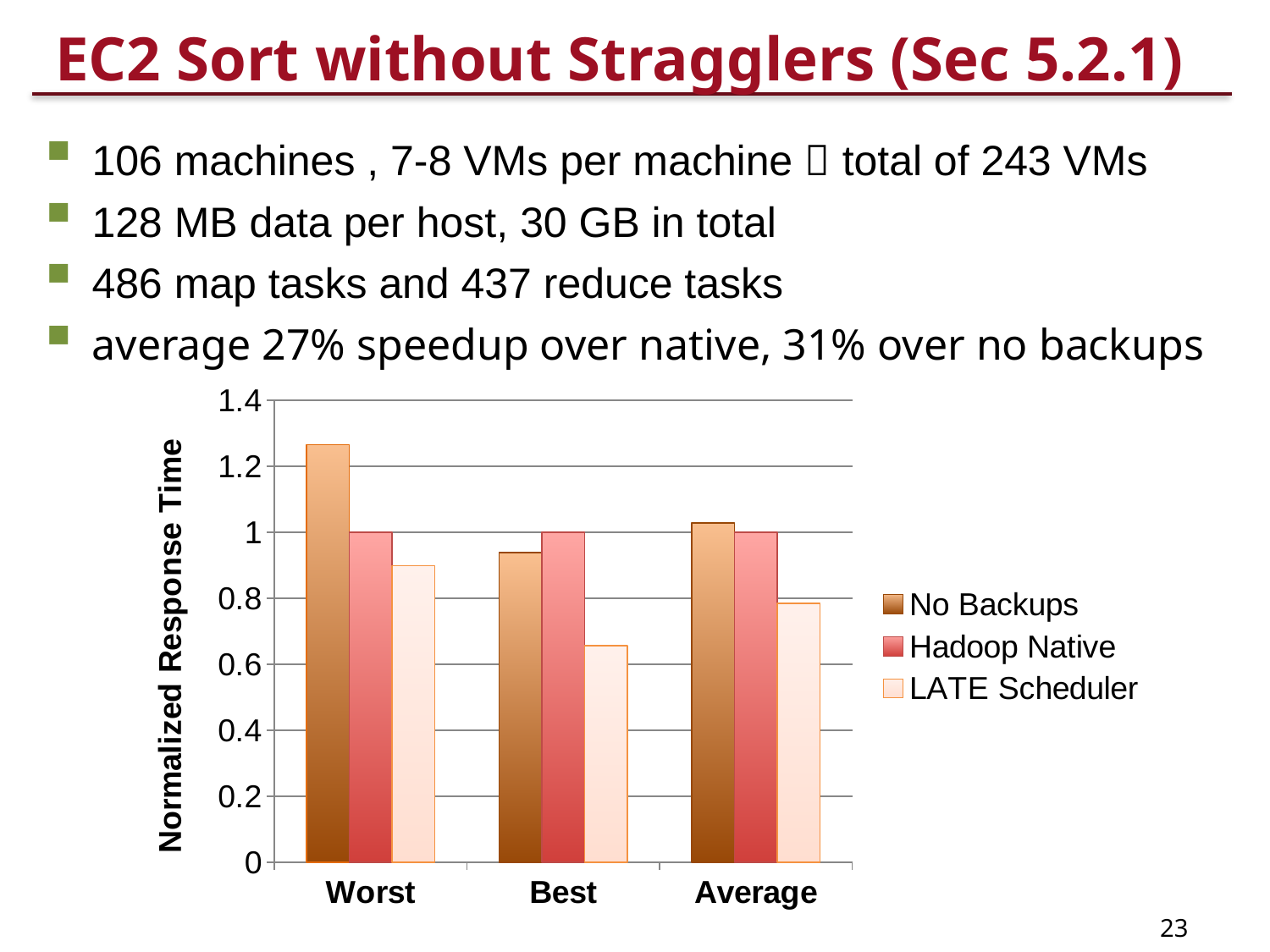
Is the value for No Backups in the Best category greater or less than 1? less What is the title of the chart's vertical axis? Normalized Response Time What is the value for Hadoop Native in the Worst category? 1 Which series has the lowest value in the Best category? LATE Scheduler How many categories are shown on the x axis of the chart? 3 Is the value for LATE Scheduler in the Best category greater or less than 0.8? less What is the value for Hadoop Native in the Average category? 1 Is the value for LATE Scheduler in the Worst category greater or less than 1? less Which series has the highest value in the Worst category? No Backups What kind of chart is shown on the slide? bar chart How many series does the chart's legend list? 3